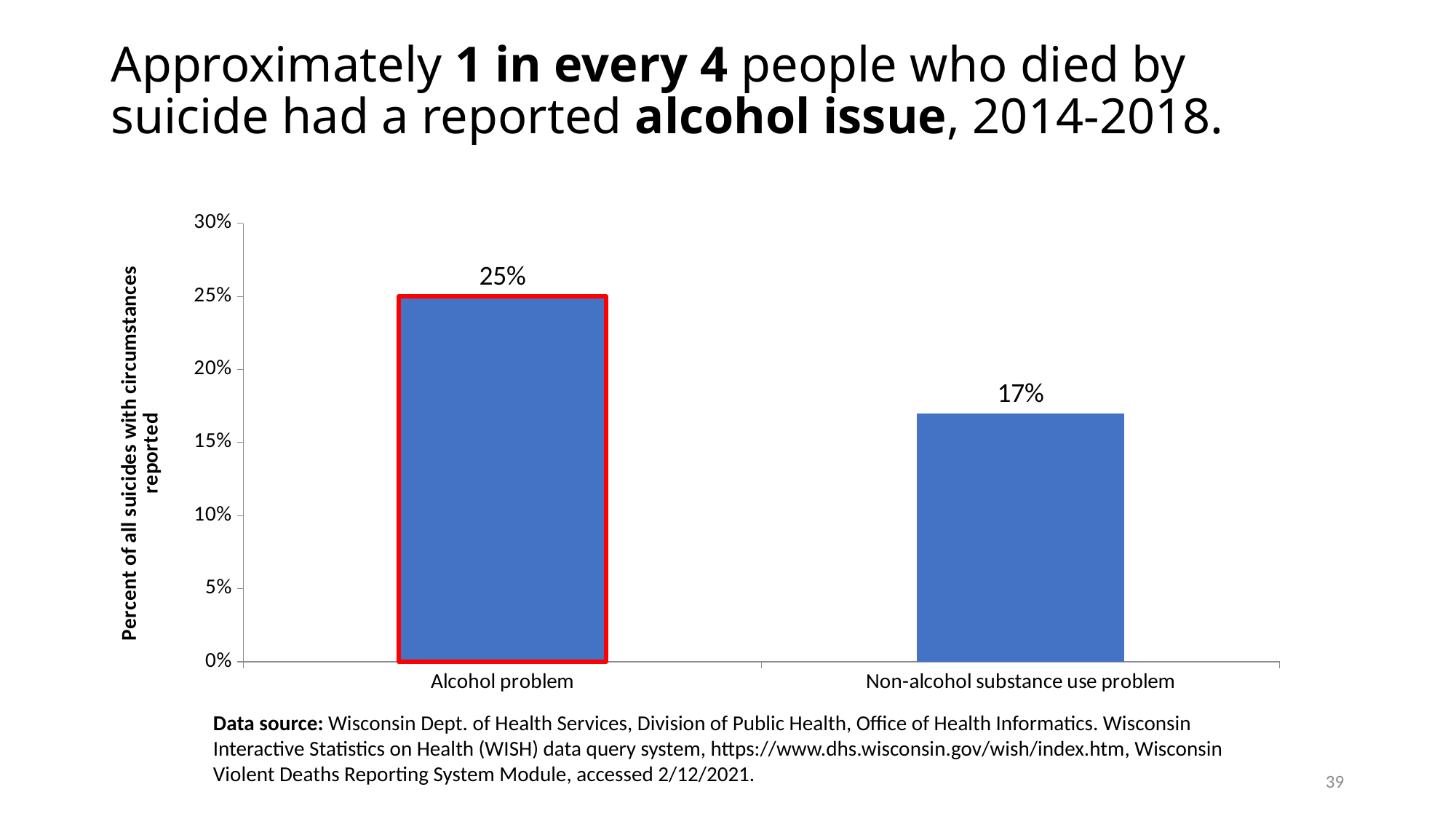
Which bar is outlined in red? Alcohol problem What is the value for Alcohol problem? 25% Is the value for Non-alcohol substance use problem greater or less than 20%? less Which category has the highest value? Alcohol problem What is the difference between the values for Alcohol problem and Non-alcohol substance use problem? 8% Is the value for Alcohol problem greater or less than 20%? greater Which is larger, the value for Alcohol problem or the value for Non-alcohol substance use problem? Alcohol problem Which category has the lowest value? Non-alcohol substance use problem What is the value for Non-alcohol substance use problem? 17% What kind of chart is shown on the slide? Bar chart What is the label of the vertical axis? Percent of all suicides with circumstances reported How many categories are shown on the x axis? 2